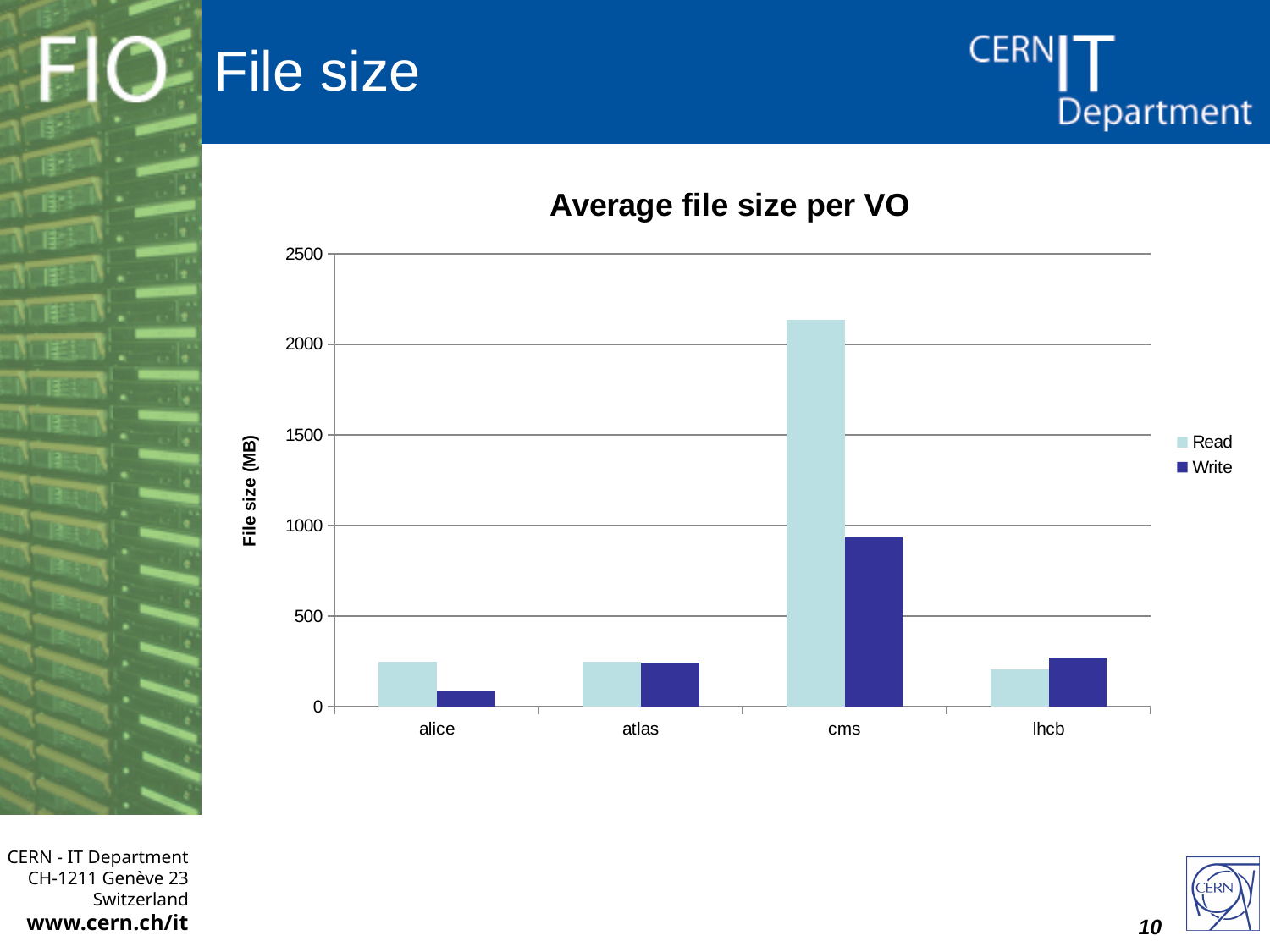
Which VO has the highest Read average file size? cms Is the Read value for cms greater or less than 2000? greater Which VO has the lowest Write average file size? alice How many VO categories are shown on the x axis? 4 For lhcb, which is larger, the Read or the Write average file size? Write How many series does the legend list? 2 What is the label of the y axis? File size (MB) Is the Write value for alice greater or less than 500? less What is the title of the chart? Average file size per VO Is the Write value for cms greater or less than 1000? less What kind of chart is shown on the slide? bar chart For cms, which is larger, the Read or the Write average file size? Read